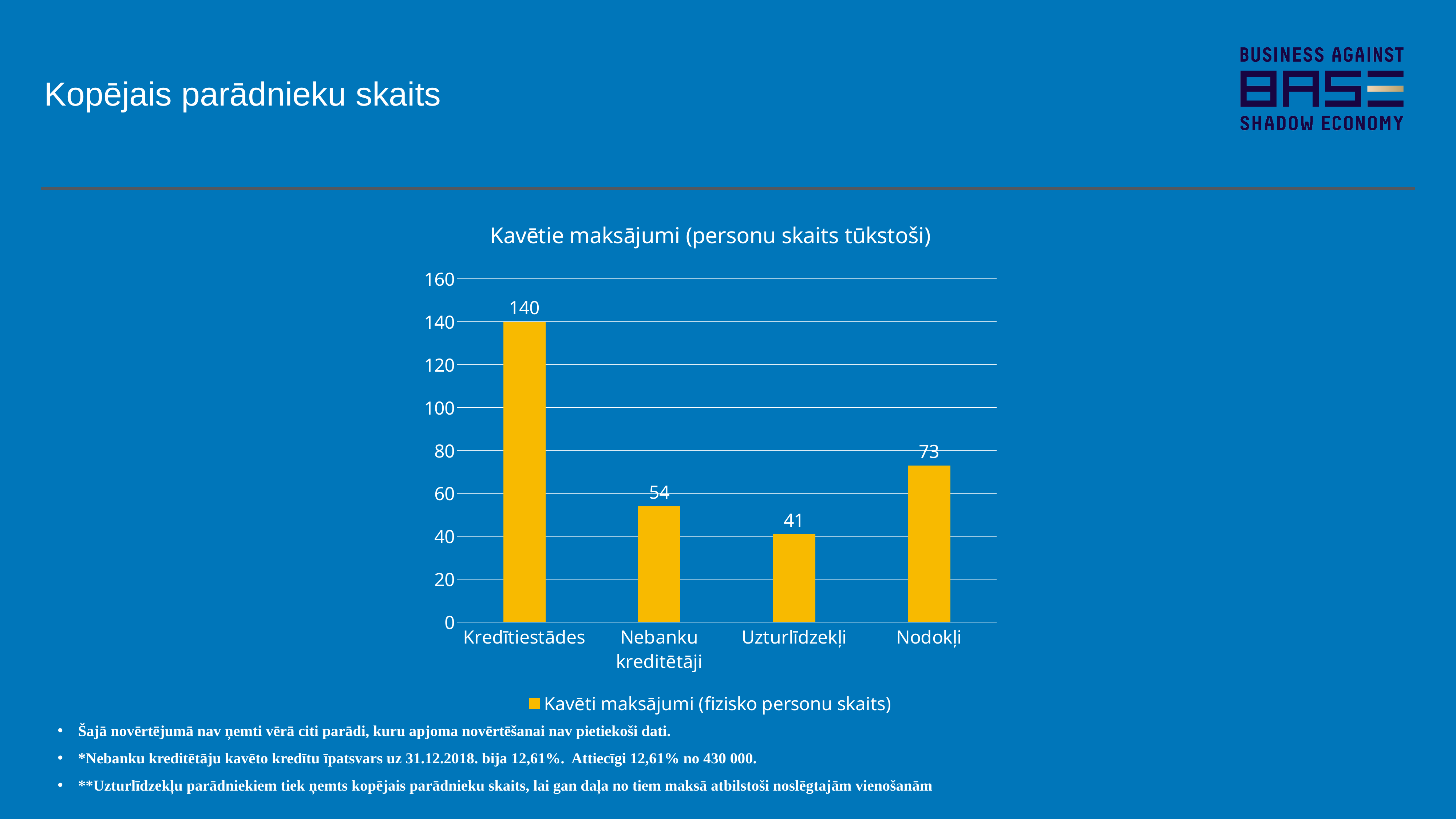
What is the value for Nebanku kreditētāji? 54 What is the value for Nodokļi? 73 What is the difference between the values for Kredītiestādes and Nodokļi? 67 What kind of chart is shown on the slide? bar chart What is the value for Uzturlīdzekļi? 41 How many categories are shown on the x axis? 4 Which is larger, the value for Nebanku kreditētāji or the value for Nodokļi? Nodokļi Is the value for Nodokļi greater or less than 80? less Which category has the highest value? Kredītiestādes Which category has the lowest value? Uzturlīdzekļi What is the title of the chart? Kavētie maksājumi (personu skaits tūkstoši) What is the value for Kredītiestādes? 140